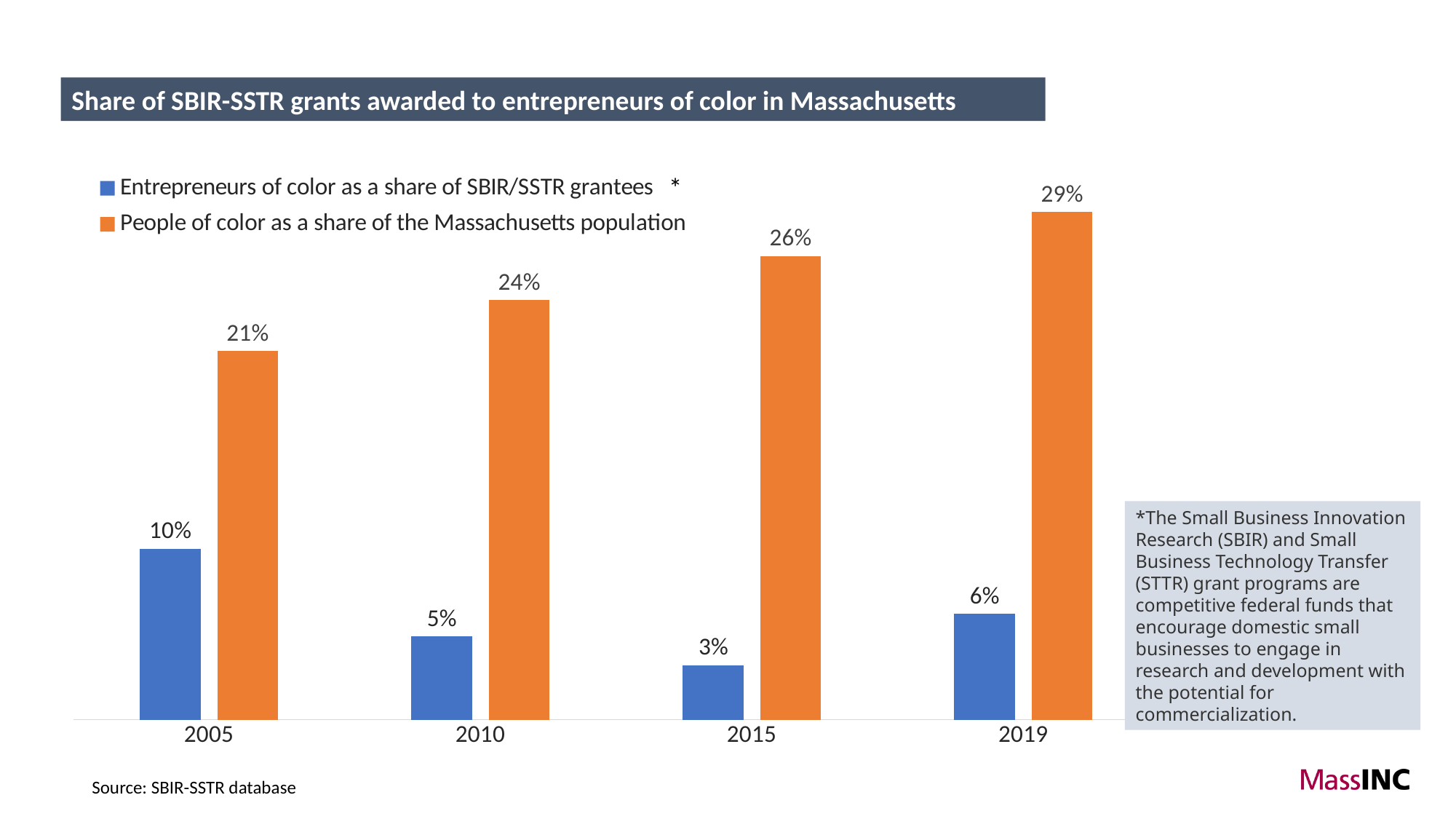
How many series does the legend list? 2 In which year was the share of entrepreneurs of color among SBIR/SSTR grantees highest? 2005 Does the share of people of color in the Massachusetts population rise or fall from 2005 to 2019? Rise What share of SBIR/SSTR grantees were entrepreneurs of color in 2005? 10% Which is larger in 2010: the share of entrepreneurs of color among grantees or the share of people of color in the Massachusetts population? People of color as a share of the Massachusetts population What share of SBIR/SSTR grantees were entrepreneurs of color in 2015? 3% What kind of chart is shown on the slide? Bar chart What was the share of people of color in the Massachusetts population in 2019? 29% What is the difference between the share of people of color in the Massachusetts population and the share of entrepreneurs of color among grantees in 2019? 23 percentage points How many years are shown on the x axis? 4 What is the source cited for the chart? SBIR-SSTR database In which year was the share of entrepreneurs of color among SBIR/SSTR grantees lowest? 2015